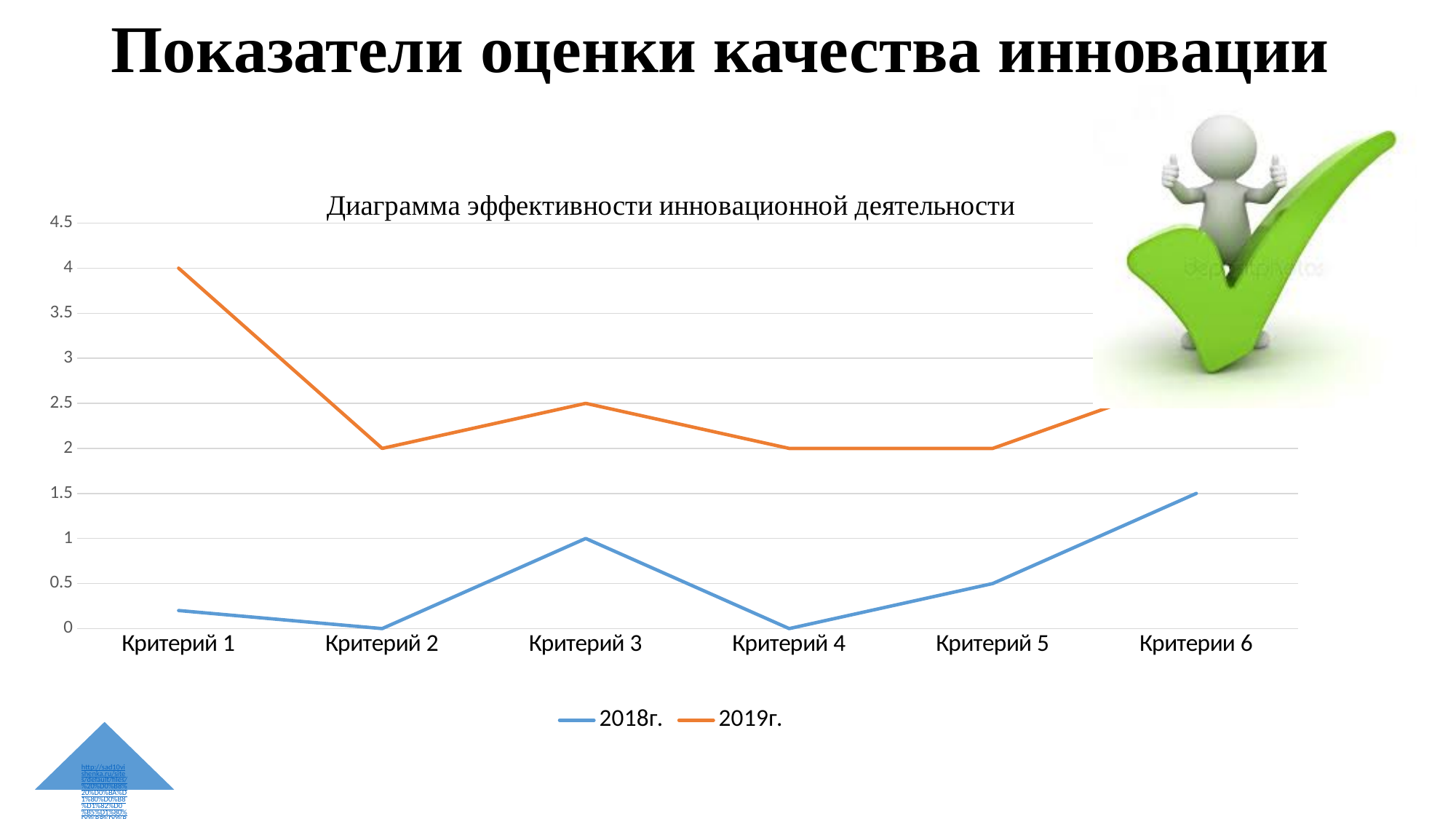
Which category has the highest value in the 2018г. series? Критерии 6 What is the value for Критерий 3 in the 2018г. series? 1 Is the value for Критерий 1 in the 2018г. series greater or less than 0.5? less Which category has the highest value in the 2019г. series? Критерий 1 How many series does the legend list? 2 What is the value for Критерии 6 in the 2018г. series? 1.5 What is the title of the chart? Диаграмма эффективности инновационной деятельности What is the value for Критерий 1 in the 2019г. series? 4 For Критерий 1, which series has the larger value, 2018г. or 2019г.? 2019г. What kind of chart is shown on the slide? Line chart What is the difference between the 2019г. values for Критерий 1 and Критерий 2? 2 How many categories are shown along the x axis? 6